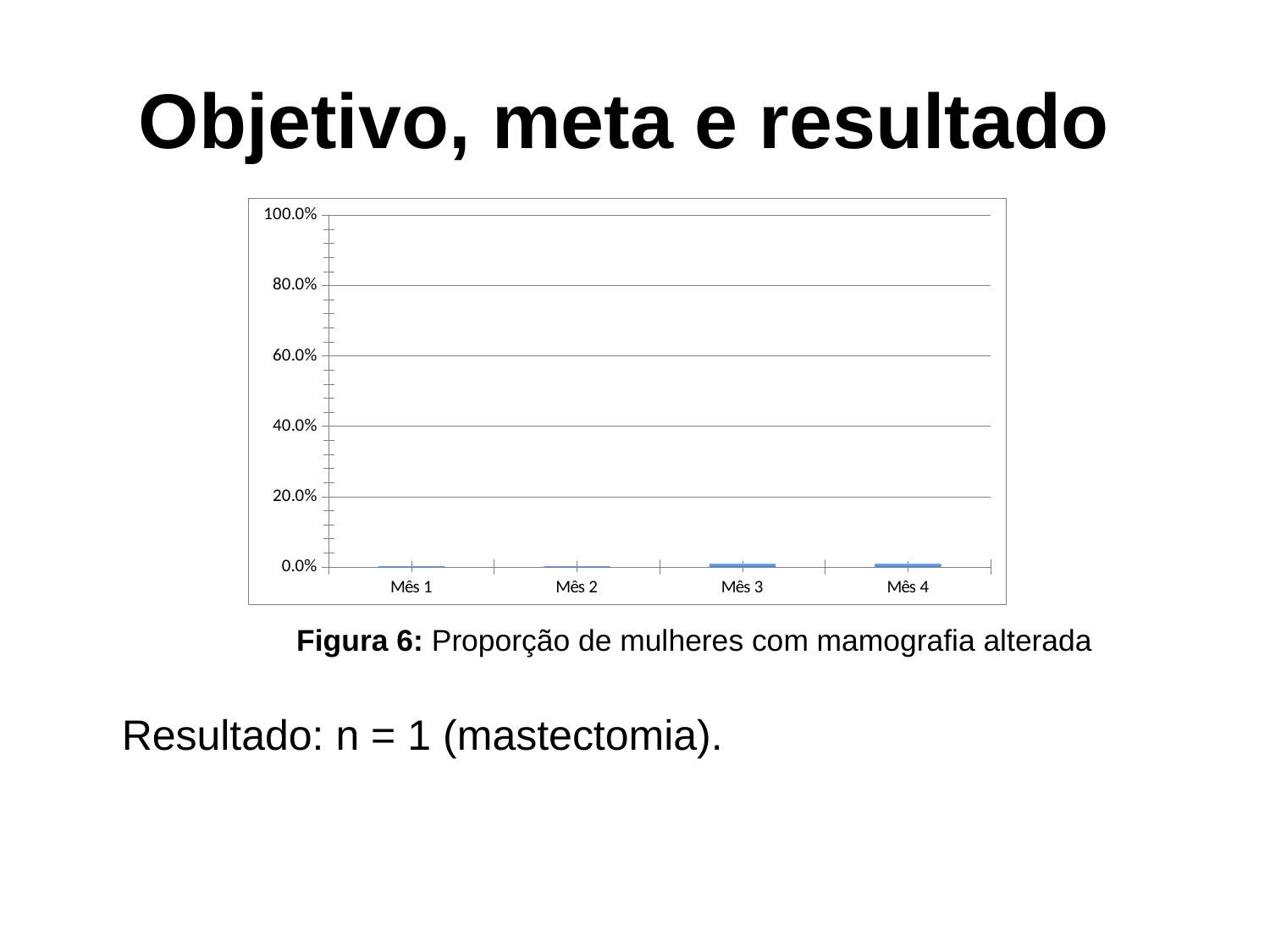
How many categories are shown on the x axis of the chart? 4 Which is larger, the value for Mês 3 or the value for Mês 1? Mês 3 Is the value for Mês 4 greater or less than 20.0%? less Which is larger, the value for Mês 4 or the value for Mês 2? Mês 4 What kind of chart is shown on the slide? bar chart Is the value for Mês 2 greater or less than 60.0%? less Is the value for Mês 3 greater or less than 20.0%? less What is the caption given for the chart on the slide? Figura 6: Proporção de mulheres com mamografia alterada What is the highest value shown on the y axis of the chart? 100.0% What is the label of the first category on the x axis? Mês 1